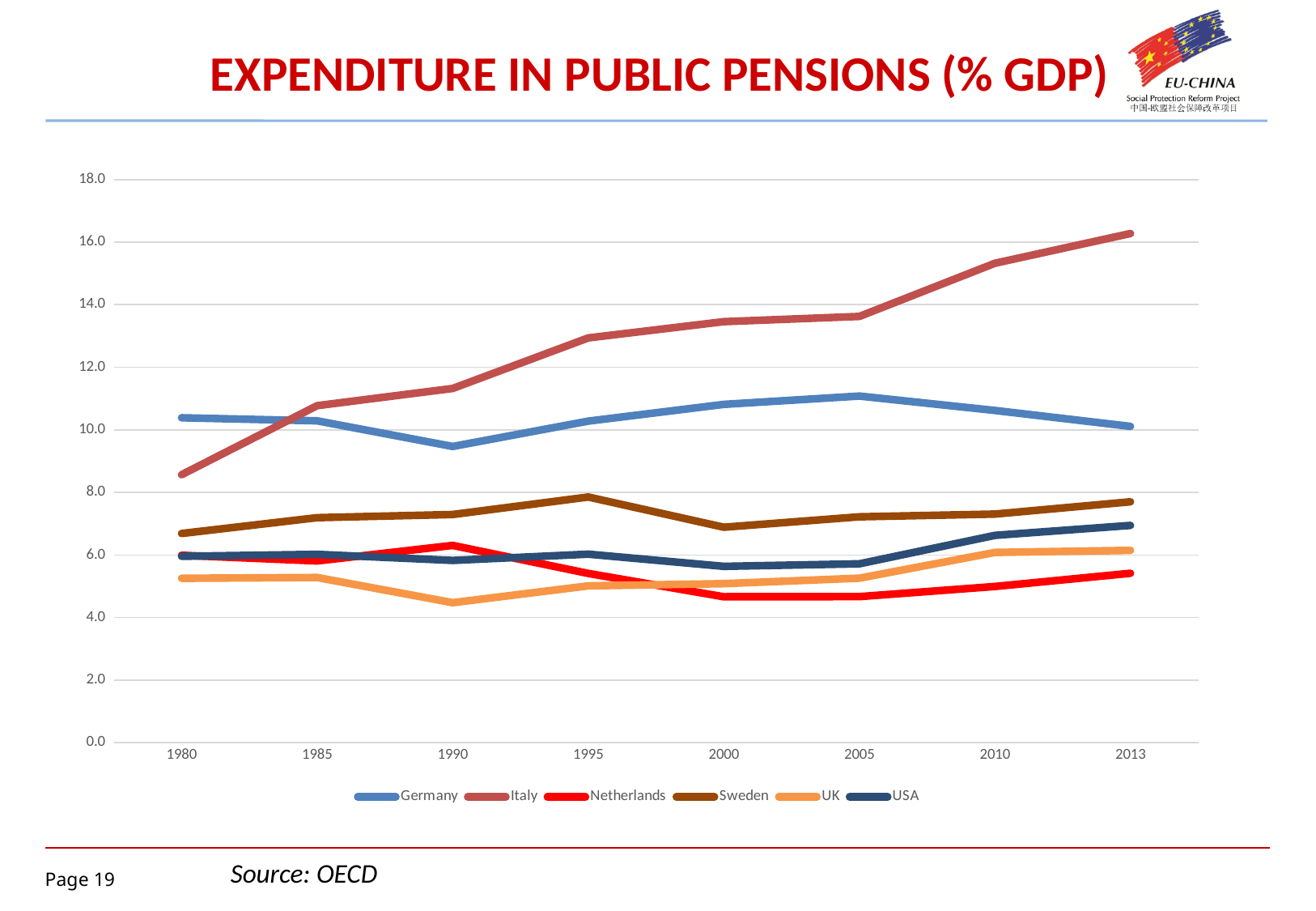
Is the value for Italy in 2013 greater or less than 14.0? greater Which is larger in 1980, the value for Germany or the value for Italy? Germany Does the value for Italy rise or fall from 1980 to 2013? rise How many series does the legend list? 6 Is the value for UK in 1990 greater or less than 6.0? less What is the title of the chart? EXPENDITURE IN PUBLIC PENSIONS (% GDP) Which country has the lowest expenditure in public pensions in 1990? UK Is the value for Germany in 1990 greater or less than 10.0? less Which country has the lowest expenditure in public pensions in 2013? Netherlands What kind of chart is shown on the slide? line chart How many years are shown on the x axis? 8 Which country has the highest expenditure in public pensions in 2013? Italy